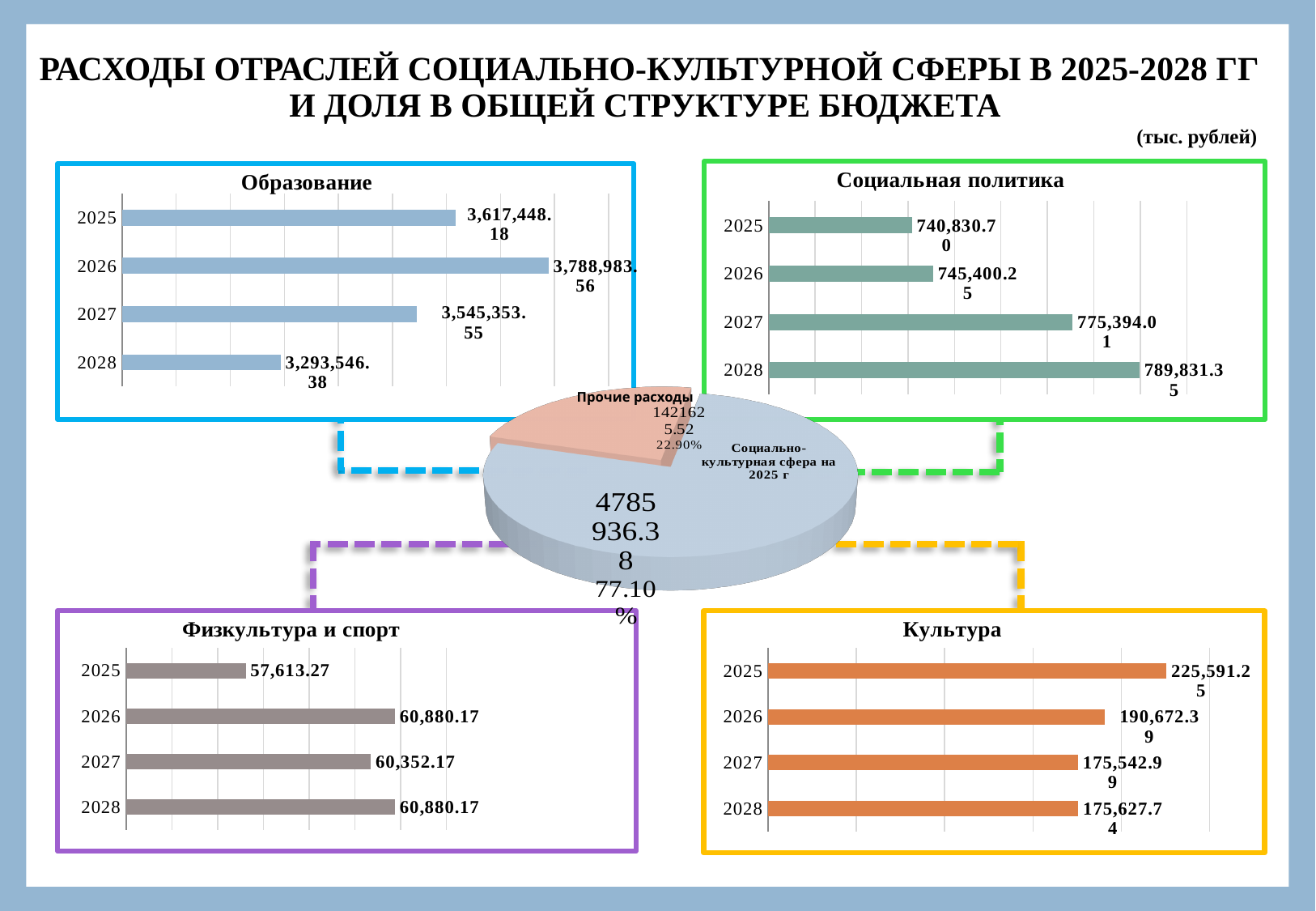
In the 'Физкультура и спорт' chart, what is the difference between the 2026 and 2027 values? 528.00 In the 'Социальная политика' chart, do the values rise or fall from 2025 to 2028? rise In the 'Образование' chart, which year has the lowest value? 2028 In the pie chart, what share does 'Прочие расходы' have? 22.90% In the 'Социальная политика' chart, what is the value for 2028? 789,831.35 How many years (categories) are shown in the 'Образование' chart? 4 In the 'Физкультура и спорт' chart, what is the value for 2025? 57,613.27 In the 'Образование' chart, what is the value for 2026? 3,788,983.56 In the pie chart, what is the value shown for 'Социально-культурная сфера на 2025 г'? 4785936.38 In the 'Культура' chart, is the value for 2025 larger or smaller than the value for 2026? larger In the 'Культура' chart, which year has the highest value? 2025 In the 'Культура' chart, what is the value for 2027? 175,542.99